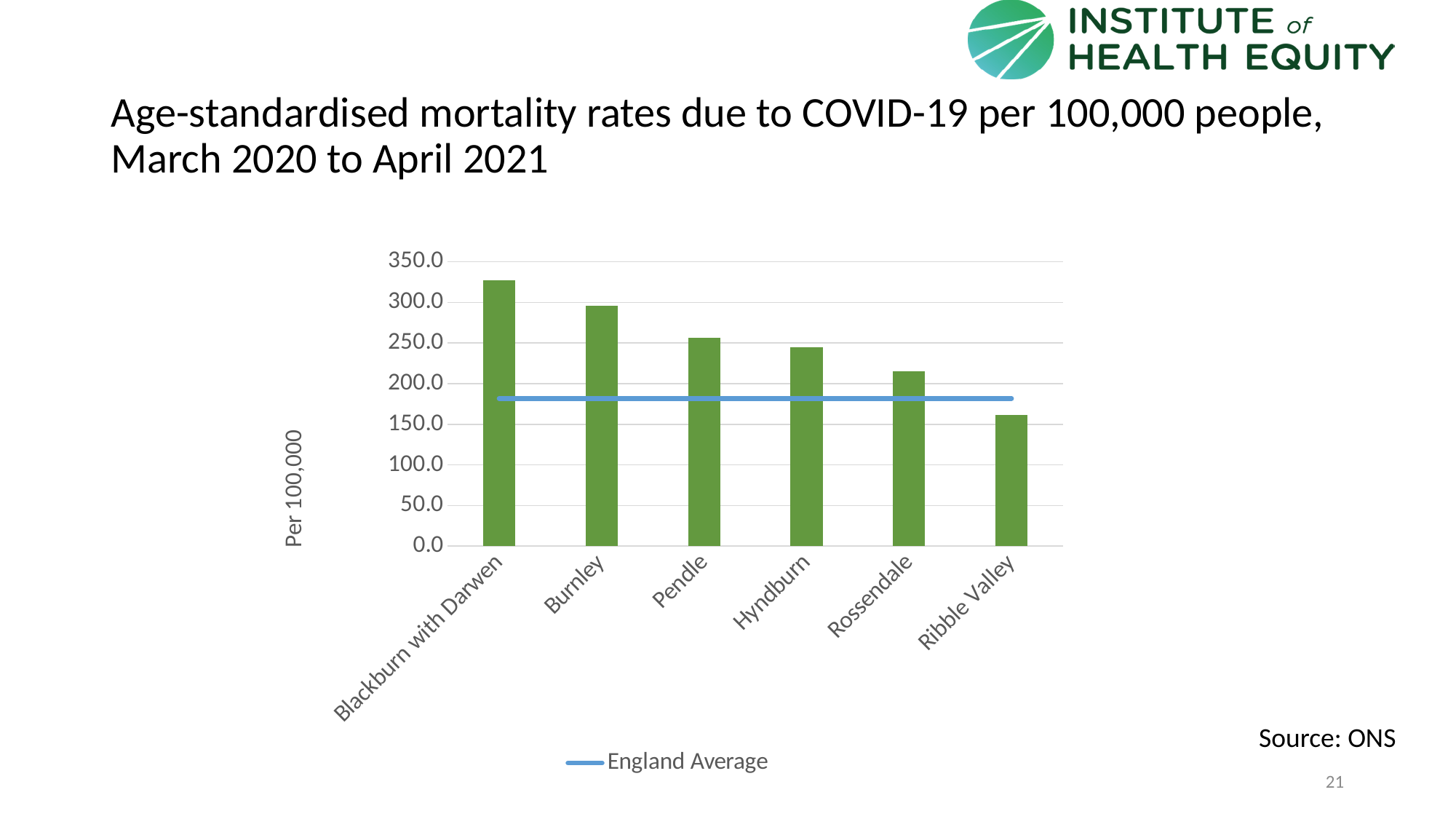
Which area has the highest age-standardised COVID-19 mortality rate in the chart? Blackburn with Darwen What kind of chart is shown on the slide? Bar chart Do the bar values rise or fall from left to right across the chart? Fall How many areas are shown as bars in the chart? 6 Is the value for Pendle greater or less than 300.0? less Which has the higher mortality rate, Rossendale or Hyndburn? Hyndburn Which area has the lowest age-standardised COVID-19 mortality rate in the chart? Ribble Valley Is the value for Ribble Valley greater or less than 200.0? less What does the blue horizontal line in the chart represent, according to the legend? England Average Which has the higher mortality rate, Burnley or Pendle? Burnley Is the value for Blackburn with Darwen greater or less than 300.0? greater